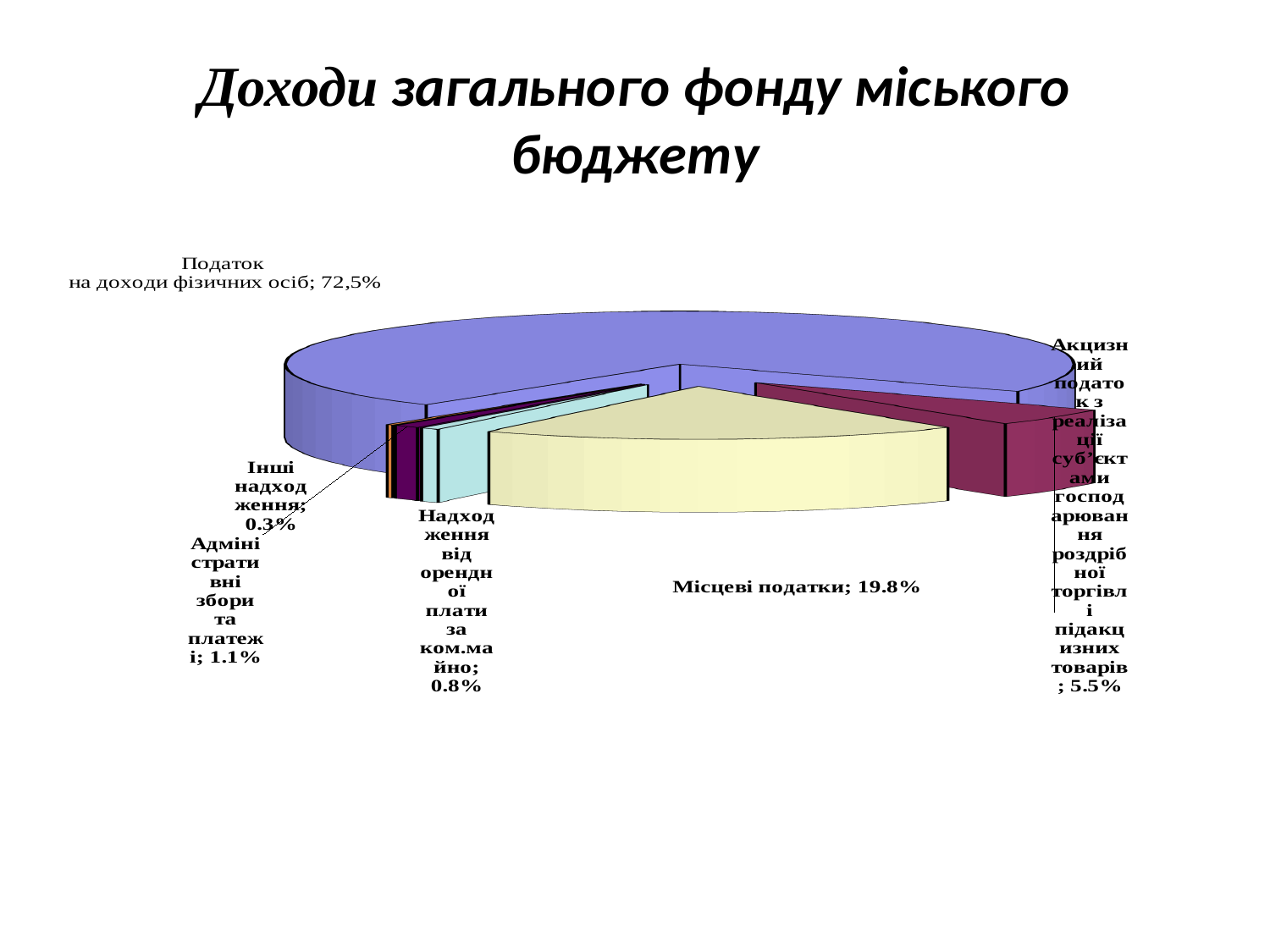
How many slices does the pie chart have? 6 What share of the pie is labelled for "Інші надходження"? 0.3% What type of chart is shown on the slide? Pie chart What share of the pie is labelled for "Надходження від орендної плати за ком.майно"? 0.8% What share of the pie is labelled for "Податок на доходи фізичних осіб"? 72,5% What is the difference in percentage points between "Місцеві податки" (19.8%) and the excise tax slice (5.5%)? 14.3 What share of the pie is labelled for "Адміністративні збори та платежі"? 1.1% What is the title of the chart on the slide? Доходи загального фонду міського бюджету Which is larger: the share for "Місцеві податки" or the share for the excise tax ("Акцизний податок") slice? Місцеві податки Which category has the smallest slice of the pie? Інші надходження Which category has the largest slice of the pie? Податок на доходи фізичних осіб What share of the pie is labelled for "Місцеві податки"? 19.8%